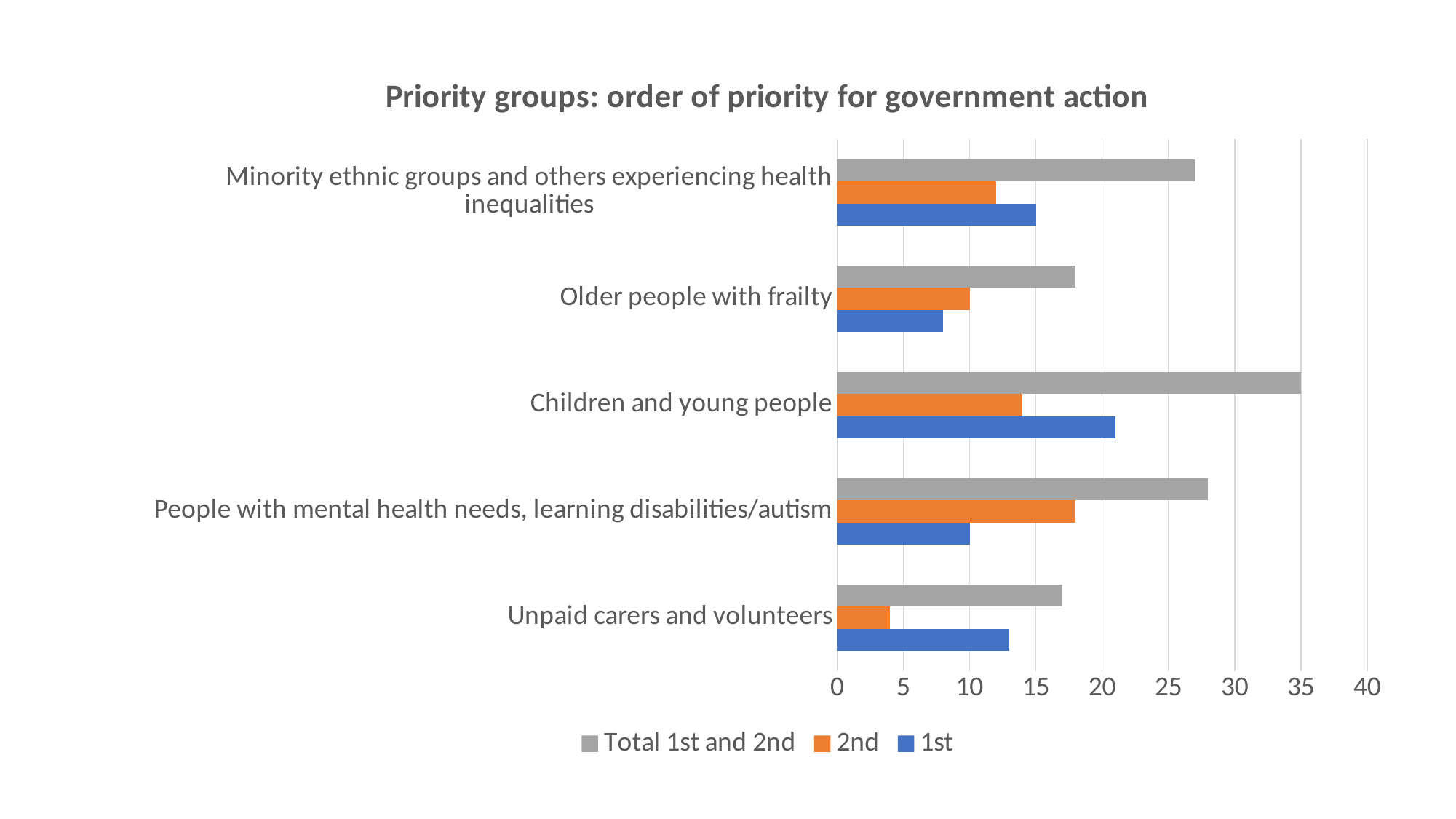
Which priority group has the highest 'Total 1st and 2nd' value? Children and young people What kind of chart is shown on the slide? bar chart How many priority groups (categories) are shown on the chart? 5 Which priority group has the lowest '2nd' value? Unpaid carers and volunteers Which priority group has the highest '1st' value? Children and young people What is the '2nd' value for Older people with frailty? 10 Is the 'Total 1st and 2nd' value for Minority ethnic groups and others experiencing health inequalities greater or less than 25? greater What is the 'Total 1st and 2nd' value for Children and young people? 35 What is the title of the chart? Priority groups: order of priority for government action For People with mental health needs, learning disabilities/autism, which is larger: the '2nd' value or the '1st' value? 2nd How many series does the legend list? 3 Is the 'Total 1st and 2nd' value for Unpaid carers and volunteers greater or less than 20? less